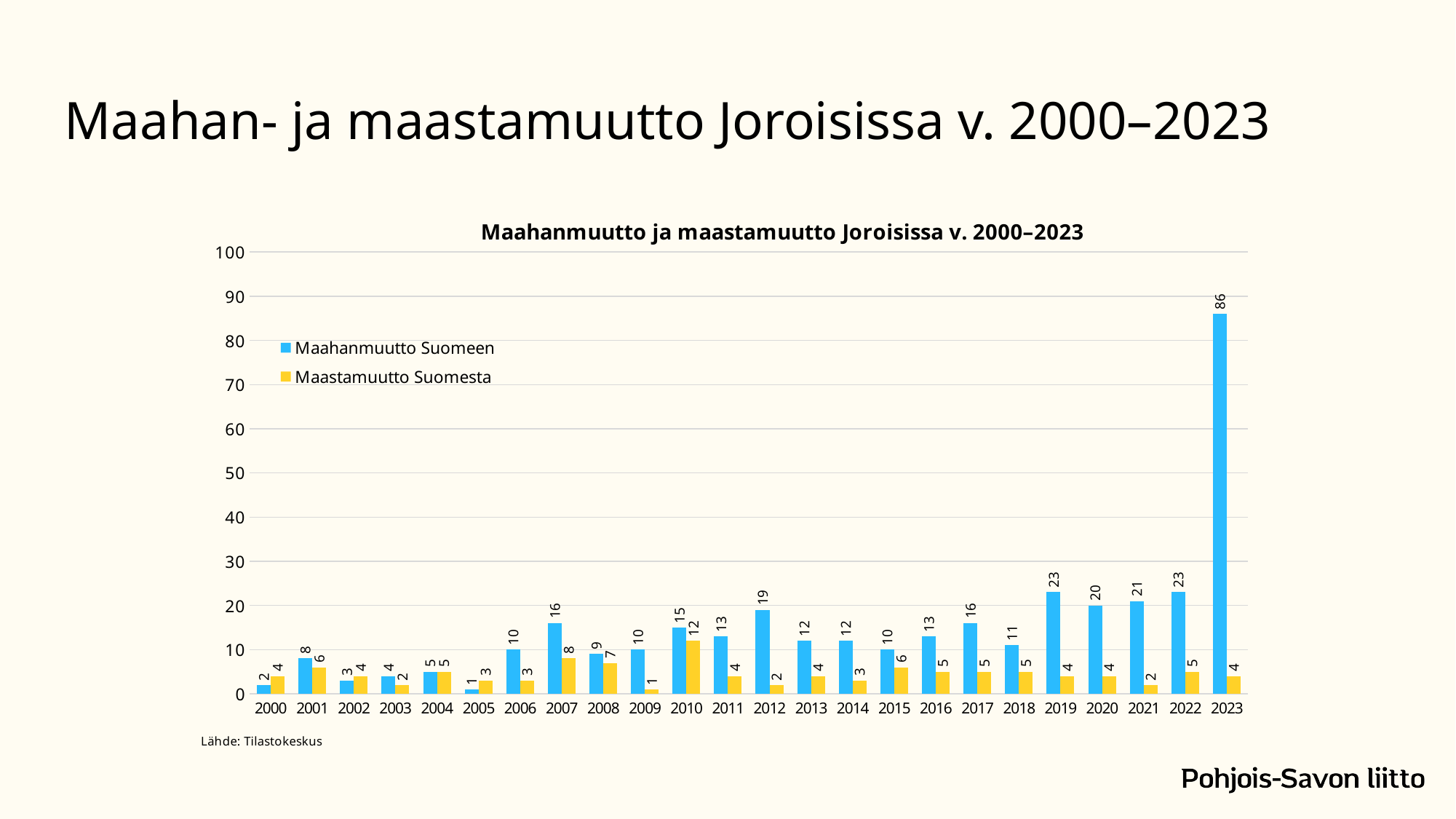
Which is larger in 2000, Maahanmuutto Suomeen or Maastamuutto Suomesta? Maastamuutto Suomesta How many series does the legend list? 2 In which year is Maahanmuutto Suomeen highest? 2023 In which year is Maahanmuutto Suomeen lowest? 2005 Is the value of Maahanmuutto Suomeen in 2023 greater or less than 80? greater What is the value of Maastamuutto Suomesta in 2010? 12 What is the difference between Maahanmuutto Suomeen and Maastamuutto Suomesta in 2023? 82 How many years are shown on the x axis? 24 In which year is Maastamuutto Suomesta highest? 2010 What kind of chart is shown on the slide? Bar chart What is the value of Maahanmuutto Suomeen in 2023? 86 What is the value of Maahanmuutto Suomeen in 2012? 19